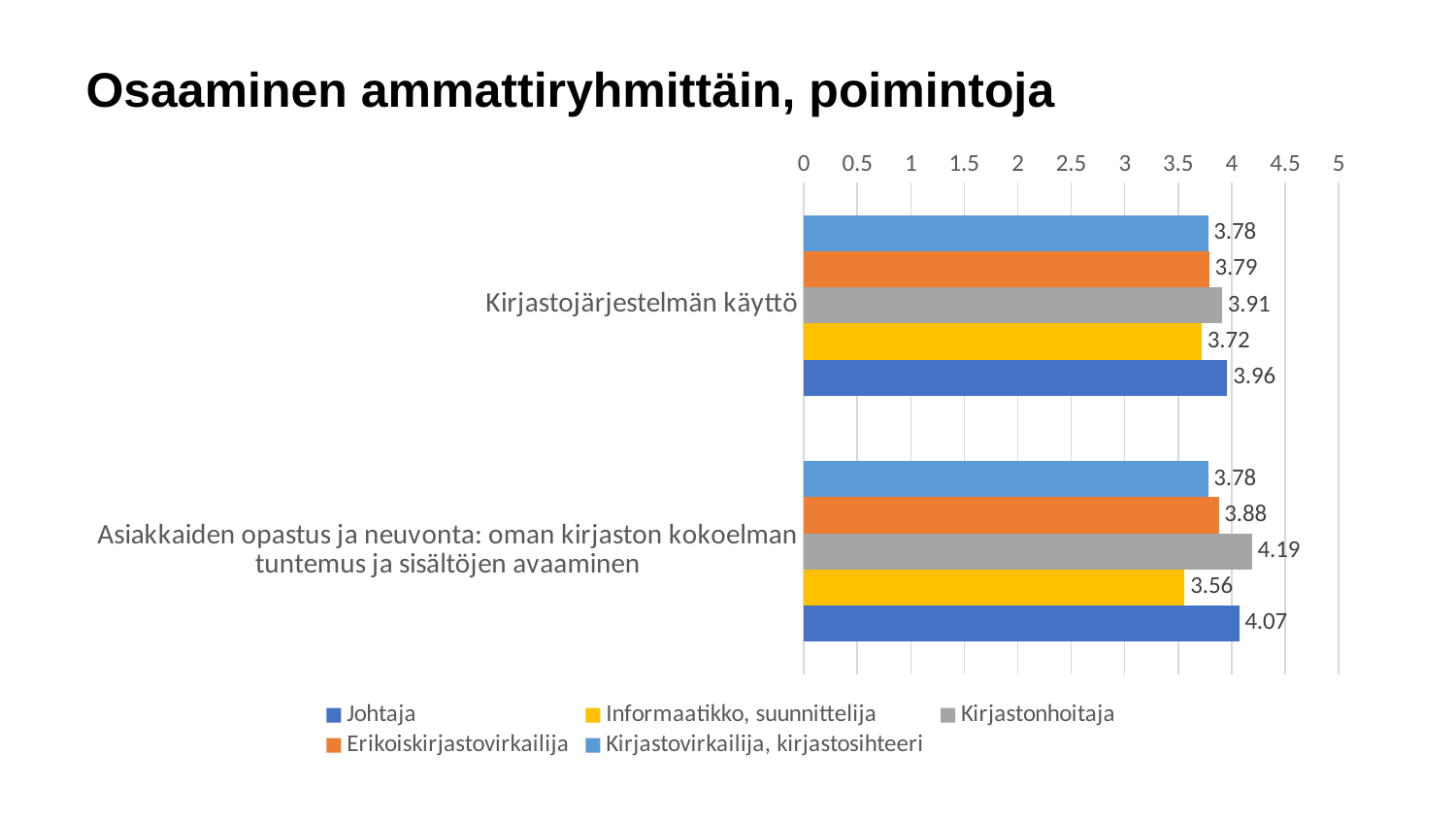
What is the title of the slide? Osaaminen ammattiryhmittäin, poimintoja How many series does the legend list? 5 What is the value for Kirjastonhoitaja in the Asiakkaiden opastus ja neuvonta category? 4.19 What is the value for Informaatikko, suunnittelija in the Asiakkaiden opastus ja neuvonta category? 3.56 Which professional group has the lowest value in the Kirjastojärjestelmän käyttö category? Informaatikko, suunnittelija Which professional group has the highest value in the Asiakkaiden opastus ja neuvonta category? Kirjastonhoitaja What is the difference between the Johtaja and Informaatikko, suunnittelija values in the Asiakkaiden opastus ja neuvonta category? 0.51 How many categories are shown on the chart? 2 Which is larger in the Kirjastojärjestelmän käyttö category: the value for Kirjastonhoitaja or for Kirjastovirkailija, kirjastosihteeri? Kirjastonhoitaja What is the value for Erikoiskirjastovirkailija in the Kirjastojärjestelmän käyttö category? 3.79 What is the value for Johtaja in the Kirjastojärjestelmän käyttö category? 3.96 What kind of chart is shown on the slide? Bar chart